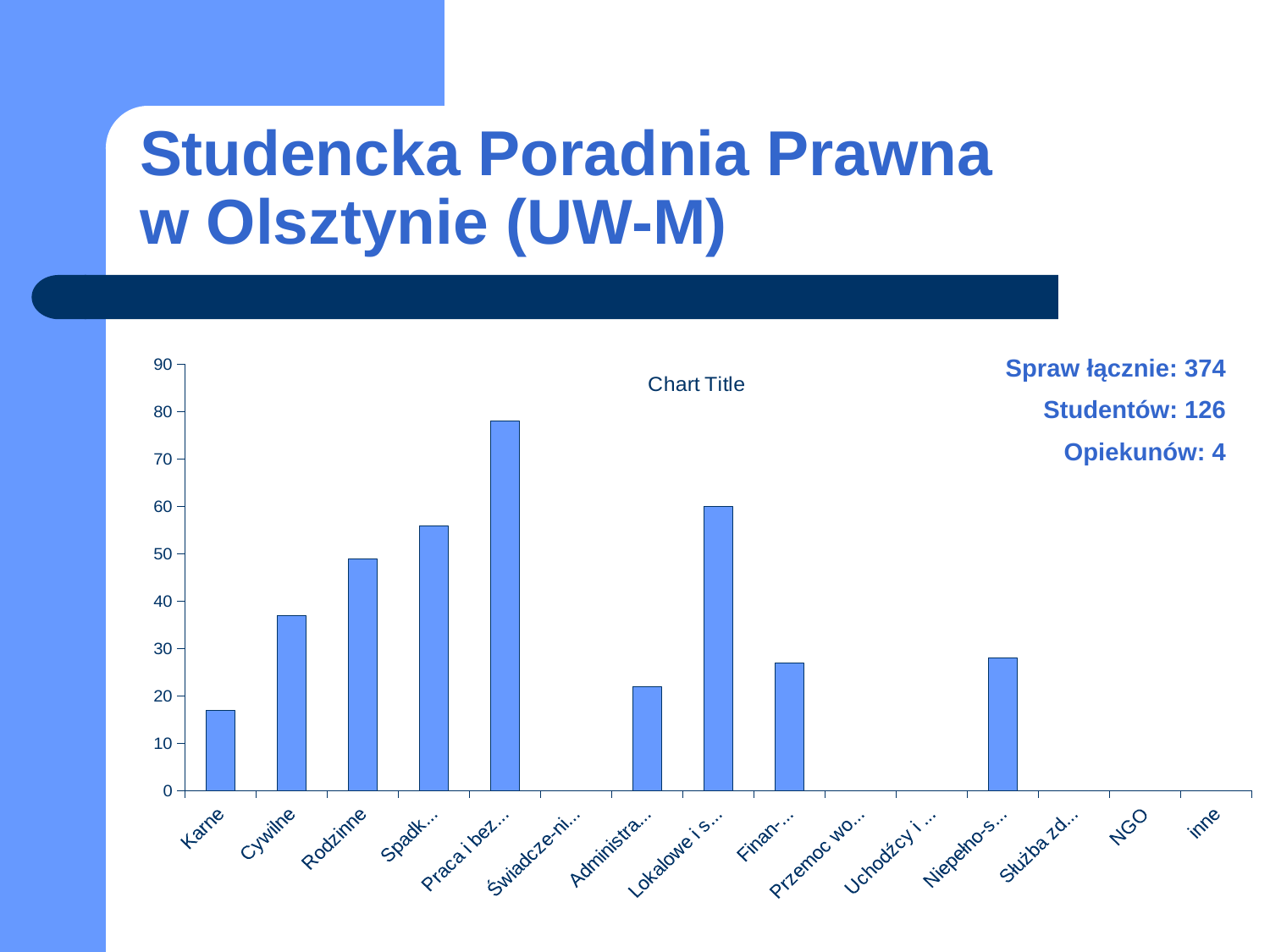
Is the value for Lokalowe i s... greater or less than 50? greater Is the value for Karne greater or less than 20? less How many categories are shown on the x axis of the chart? 15 What kind of chart is shown on the slide? bar chart Is the value for Administra... greater or less than 30? less Which is larger, the value for Cywilne or the value for Rodzinne? Rodzinne Which is larger, the value for Spadk... or the value for Lokalowe i s...? Lokalowe i s... Which category has the highest bar in the chart? Praca i bez... What is the title shown on the chart? Chart Title